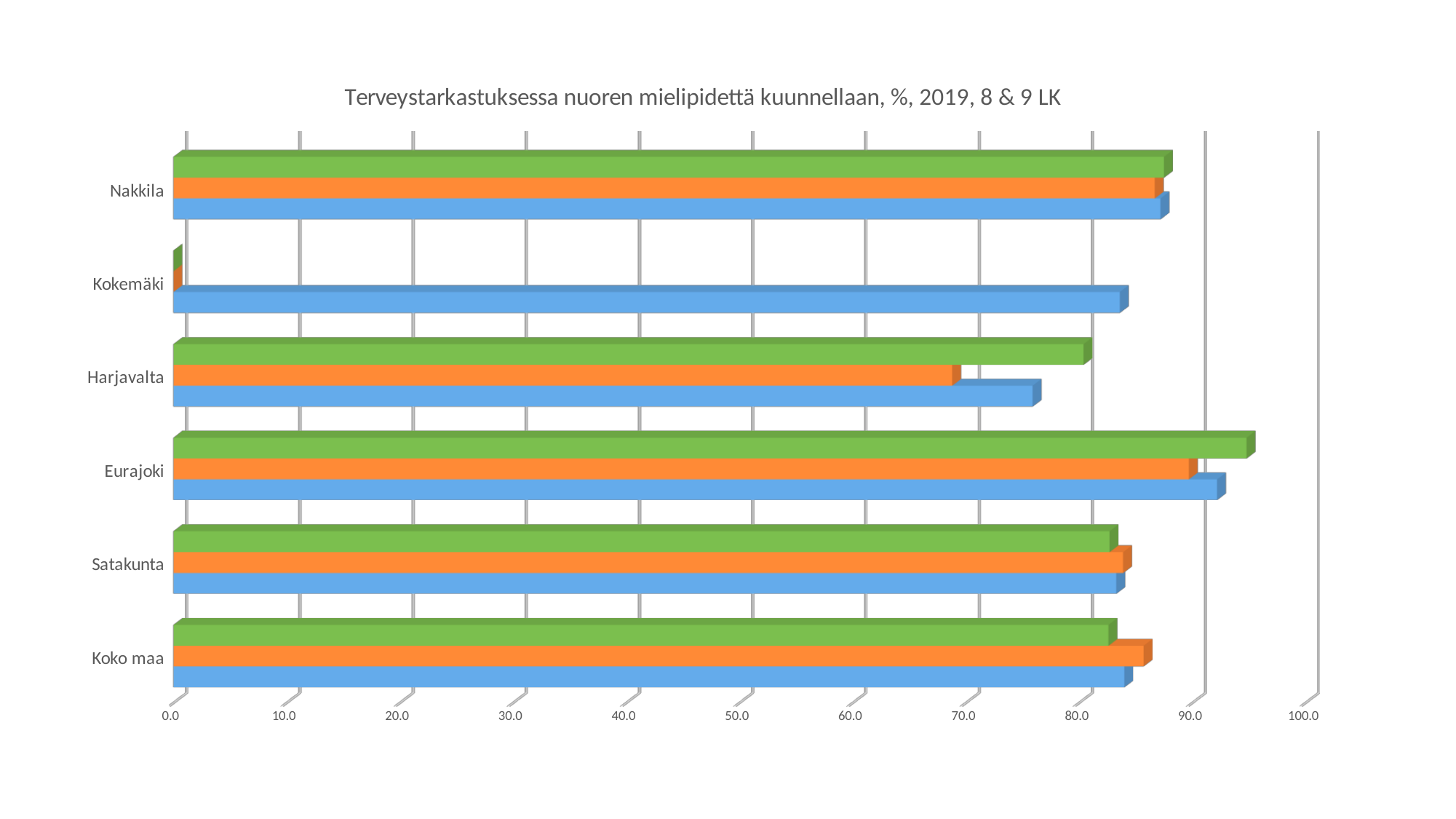
What is the highest value shown on the horizontal axis of the chart? 100.0 Which category has the shortest blue bar? Harjavalta Is the value of the blue bar for Kokemäki greater or less than 80.0? greater What is the title of the chart? Terveystarkastuksessa nuoren mielipidettä kuunnellaan, %, 2019, 8 & 9 LK Is the value of the orange bar for Harjavalta greater or less than 70.0? less Which category has the longest green bar? Eurajoki Which category has the shortest orange bar? Kokemäki Is the value of the green bar for Eurajoki greater or less than 90.0? greater For Harjavalta, which is larger: the blue bar or the orange bar? the blue bar How many categories are shown on the vertical axis of the chart? 6 What kind of chart is shown on the slide? bar chart How many bars are plotted for each category in the chart? 3